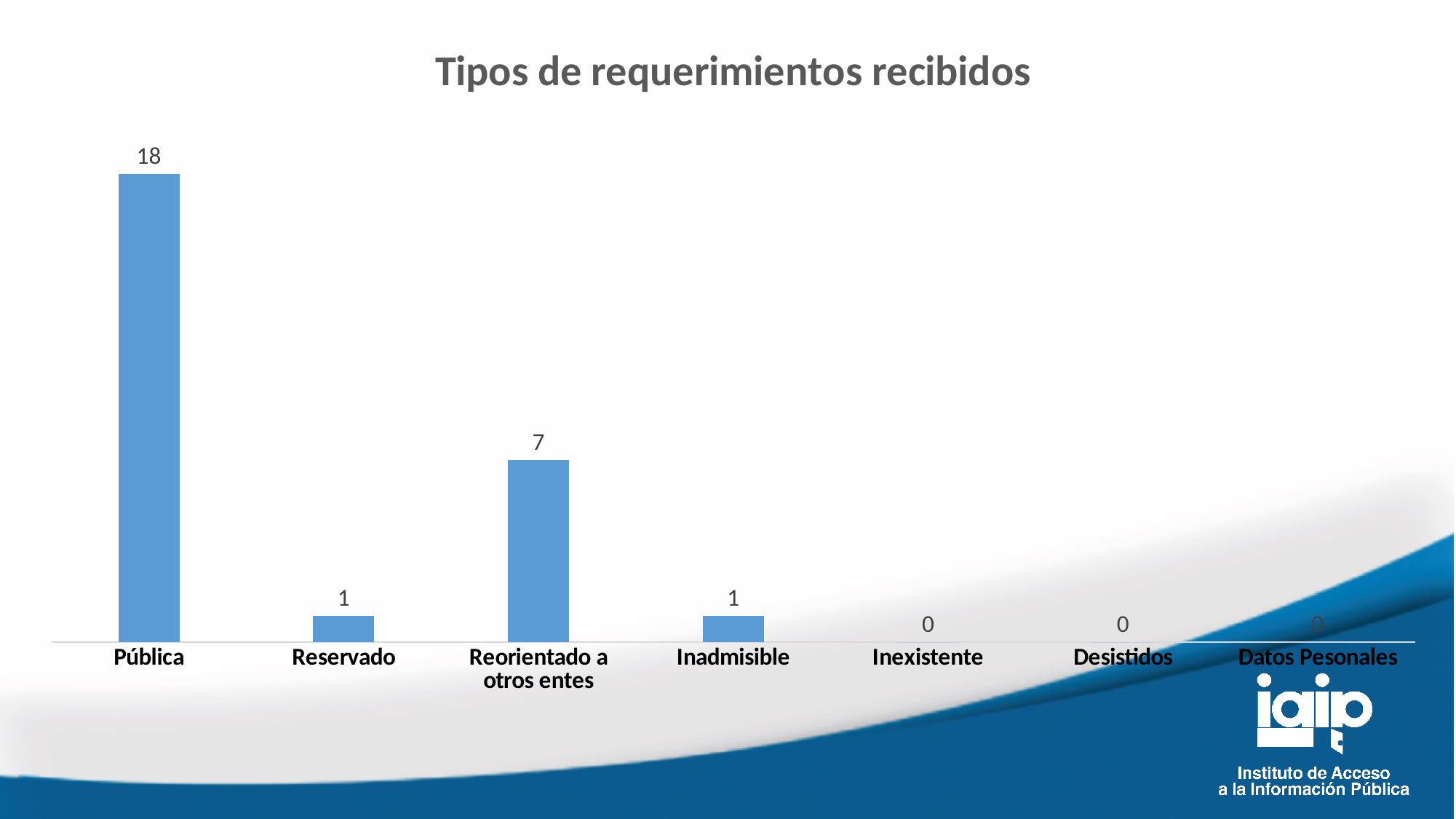
What is the value for Inadmisible? 1 What is the difference between the values for Reorientado a otros entes and Inadmisible? 6 What is the value for Inexistente? 0 Which is larger, the value for Reservado or the value for Reorientado a otros entes? Reorientado a otros entes How many categories have a value of 0? 3 Which category has the highest value? Pública What is the value for Reorientado a otros entes? 7 How many categories are shown on the x axis? 7 What is the value for Pública? 18 What kind of chart is shown on the slide? Bar chart What is the difference between the values for Pública and Reorientado a otros entes? 11 What is the title of the chart? Tipos de requerimientos recibidos